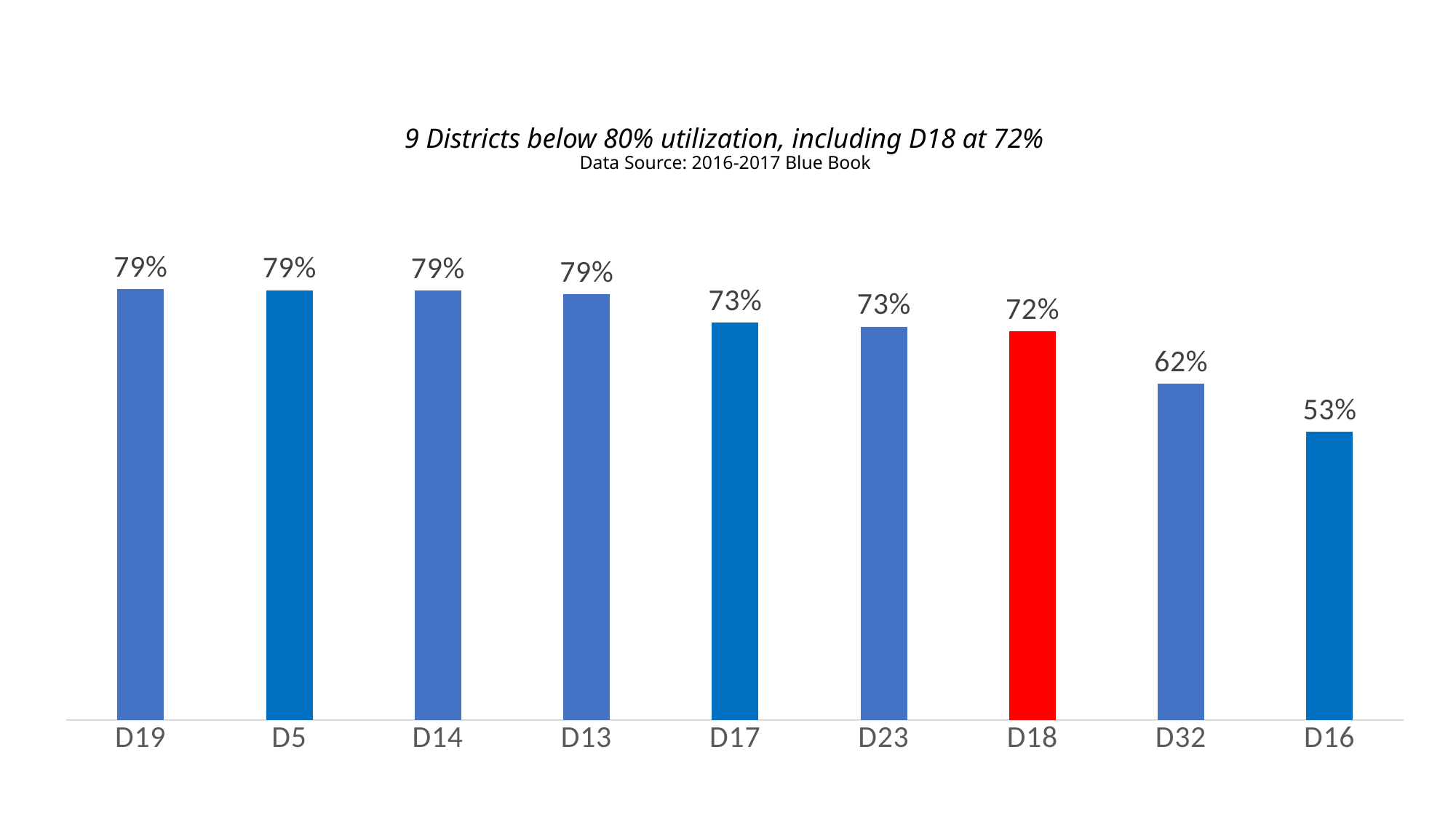
What kind of chart is shown on the slide? Bar chart What is the difference between the utilization of D19 and D16? 26% Which district's bar is coloured red? D18 What is the utilization value for D18? 72% Which has a higher utilization, D23 or D32? D23 What is the difference between the utilization of D18 and D32? 10% What is the utilization value for D17? 73% How many districts are shown in the chart? 9 Do the values rise or fall from left to right across the chart? Fall What is the utilization value for D16? 53% What is the utilization value for D32? 62% Which district has the lowest utilization? D16